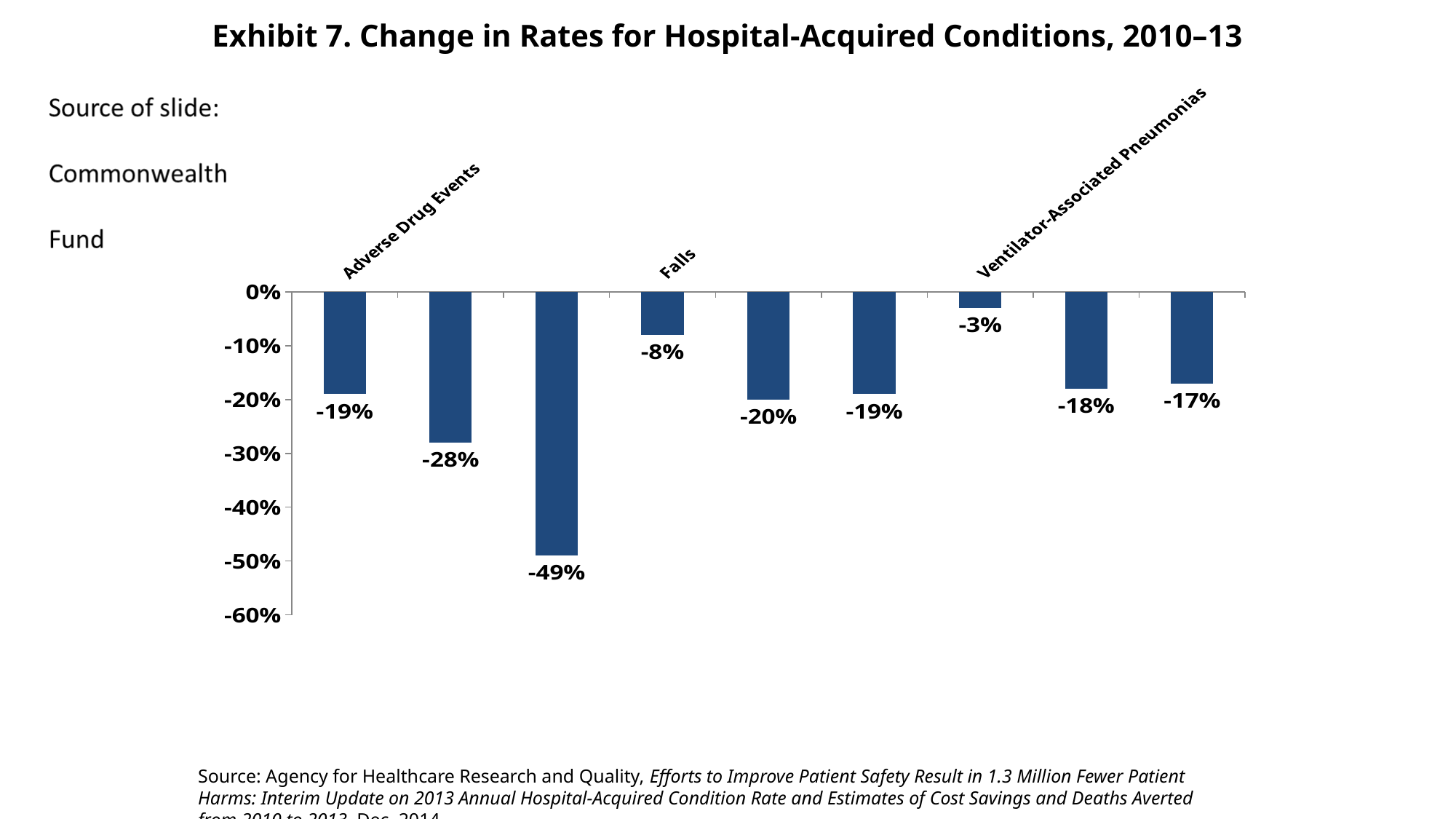
What kind of chart is shown on the slide? Bar chart What is the title of the chart? Exhibit 7. Change in Rates for Hospital-Acquired Conditions, 2010–13 What is the lowest value shown on the vertical axis? -60% Which shows a larger decline in rate, Falls or Ventilator-Associated Pneumonias? Falls What is the change in rate for Ventilator-Associated Pneumonias? -3% Is the value for Adverse Drug Events greater or less than -10%? less What is the difference in percentage points between the change for Adverse Drug Events and the change for Falls? 11 percentage points What is the change in rate for Adverse Drug Events? -19% What is the lowest (most negative) value shown on the chart? -49% What is the change in rate for Falls? -8% How many bars are plotted on the chart? 9 Which labeled category has the smallest decline in rate? Ventilator-Associated Pneumonias